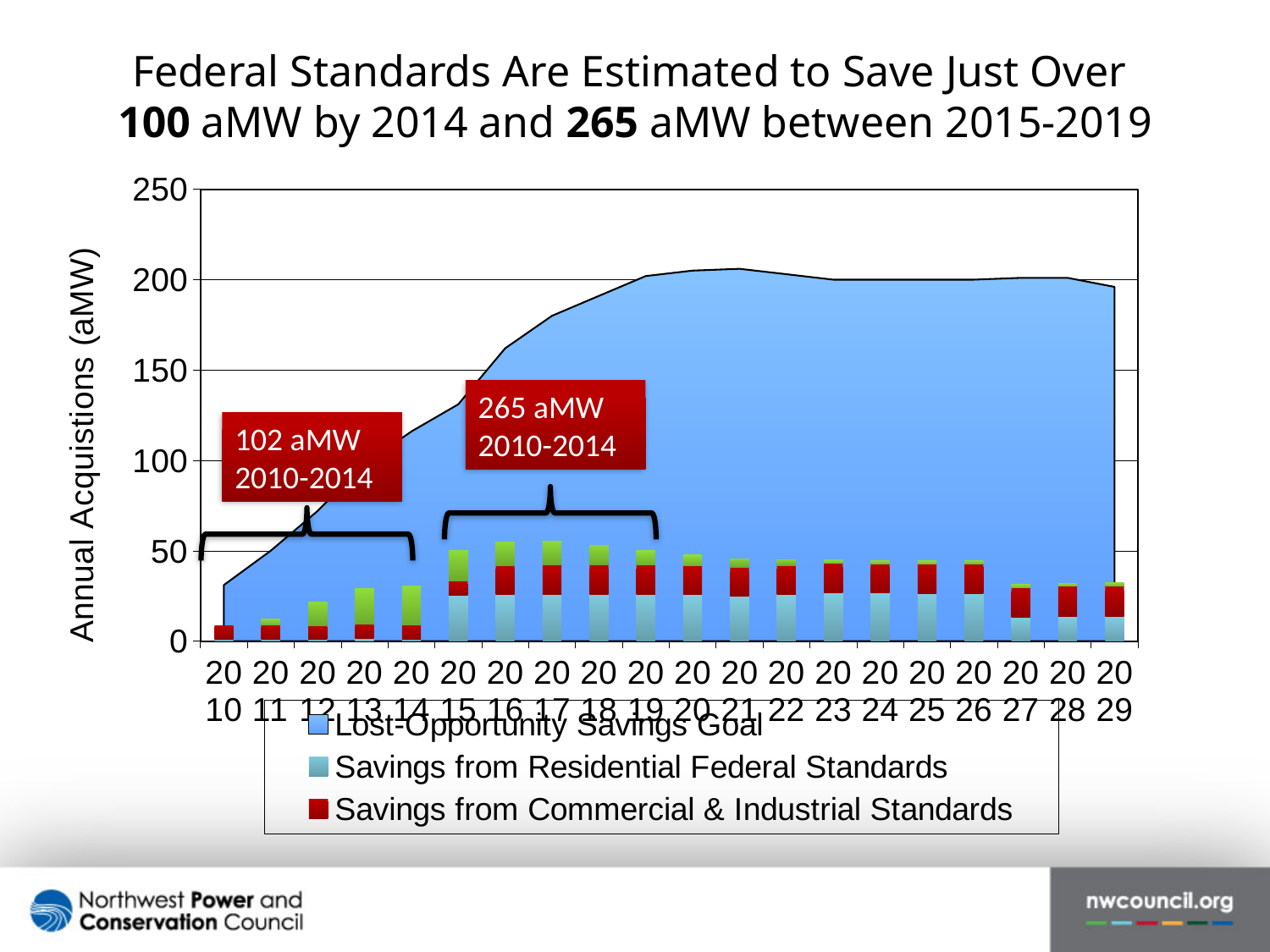
What is the label on the vertical axis of the chart? Annual Acquistions (aMW) What is the highest value shown on the vertical axis of the chart? 250 How many entries does the chart legend list? 3 Is the Lost-Opportunity Savings Goal value for 2010 greater or less than 50? less Is the Lost-Opportunity Savings Goal value for 2025 greater or less than 150? greater Is the total height of the stacked bar for 2015 greater or less than 100? less According to the annotation box on the chart, how many aMW are attributed to the 2010-2014 period? 102 aMW How many years are shown along the x axis of the chart? 20 Which is larger, the Lost-Opportunity Savings Goal in 2010 or in 2020? 2020 Which series is shown in red in the chart legend? Savings from Commercial & Industrial Standards What is the first year shown on the x axis of the chart? 2010 Does the Lost-Opportunity Savings Goal rise or fall from 2010 to 2020? rise